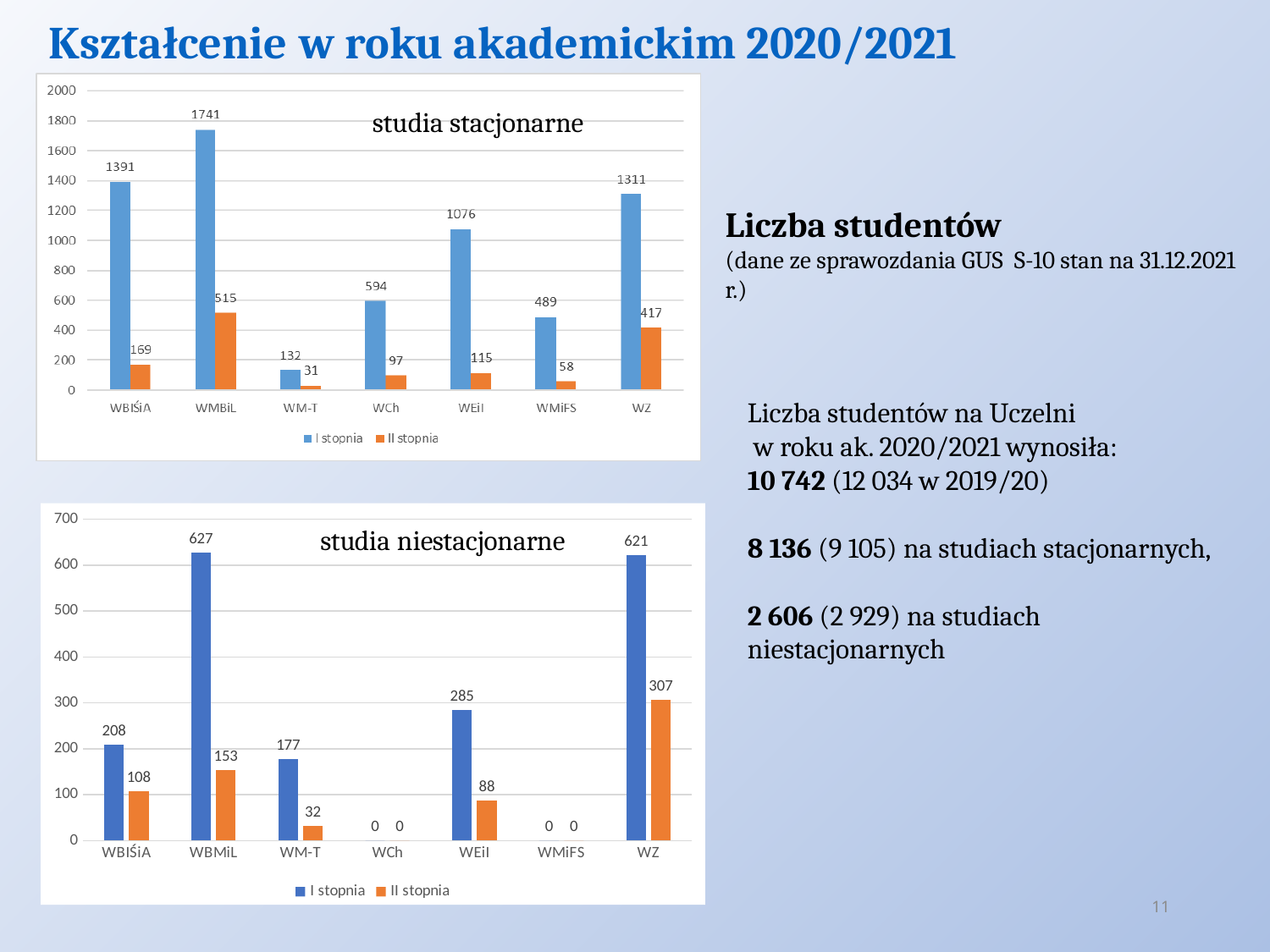
In the 'studia niestacjonarne' chart, how many faculties are shown on the x axis? 7 In the 'studia niestacjonarne' chart, which faculty has the highest I stopnia value? WBMiL In the 'studia stacjonarne' chart, what is the value for I stopnia at WMBiL? 1741 In the 'studia stacjonarne' chart, what is the difference between the I stopnia and II stopnia values at WBIŚiA? 1222 In the 'studia stacjonarne' chart, what is the value for II stopnia at WZ? 417 In the 'studia stacjonarne' chart, which faculty has the highest I stopnia value? WMBiL In the 'studia niestacjonarne' chart, what is the value for I stopnia at WEiI? 285 In the 'studia stacjonarne' chart, how many series does the legend list? 2 What type of chart is the 'studia niestacjonarne' chart? Bar chart In the 'studia niestacjonarne' chart, what is the value for II stopnia at WZ? 307 In the 'studia niestacjonarne' chart, which is larger: the I stopnia value at WBIŚiA or at WM-T? WBIŚiA In the 'studia stacjonarne' chart, which faculty has the lowest I stopnia value? WM-T